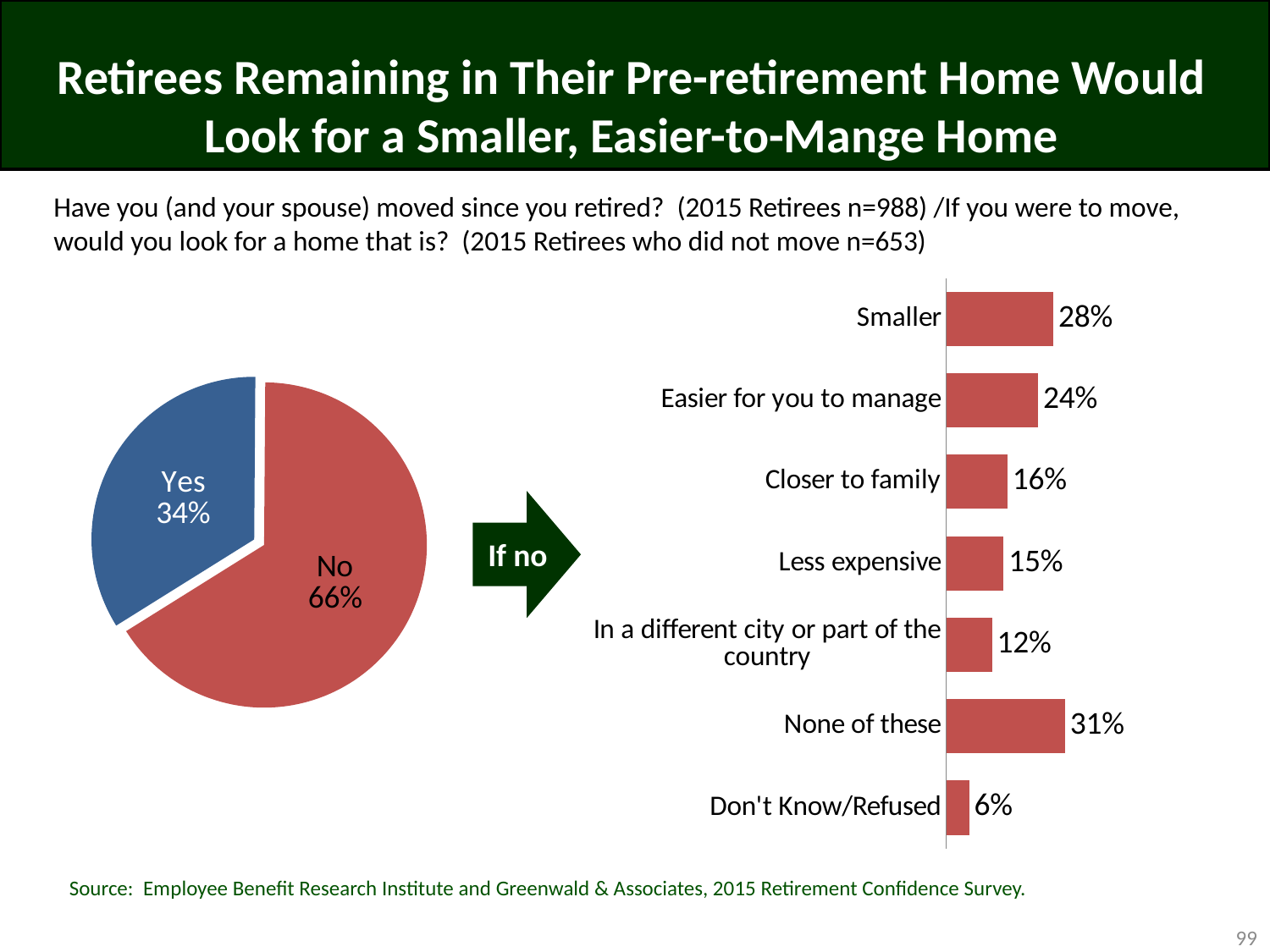
In the bar chart on the right, how many categories are shown? 7 In the bar chart on the right, which category has the lowest value? Don't Know/Refused What kind of chart is on the right side of the slide? Bar chart In the pie chart on the left, what share of retirees answered No to having moved since retiring? 66% In the bar chart on the right, what is the difference between Smaller and Easier for you to manage? 4% In the bar chart on the right, which is larger, Less expensive or In a different city or part of the country? Less expensive In the bar chart on the right, what is the value for Closer to family? 16% In the bar chart on the right, what is the value for Smaller? 28% In the pie chart on the left, what share of retirees answered Yes? 34% In the pie chart on the left, how many slices are there? 2 In the bar chart on the right, which category has the highest value? None of these In the pie chart on the left, which slice is larger, Yes or No? No